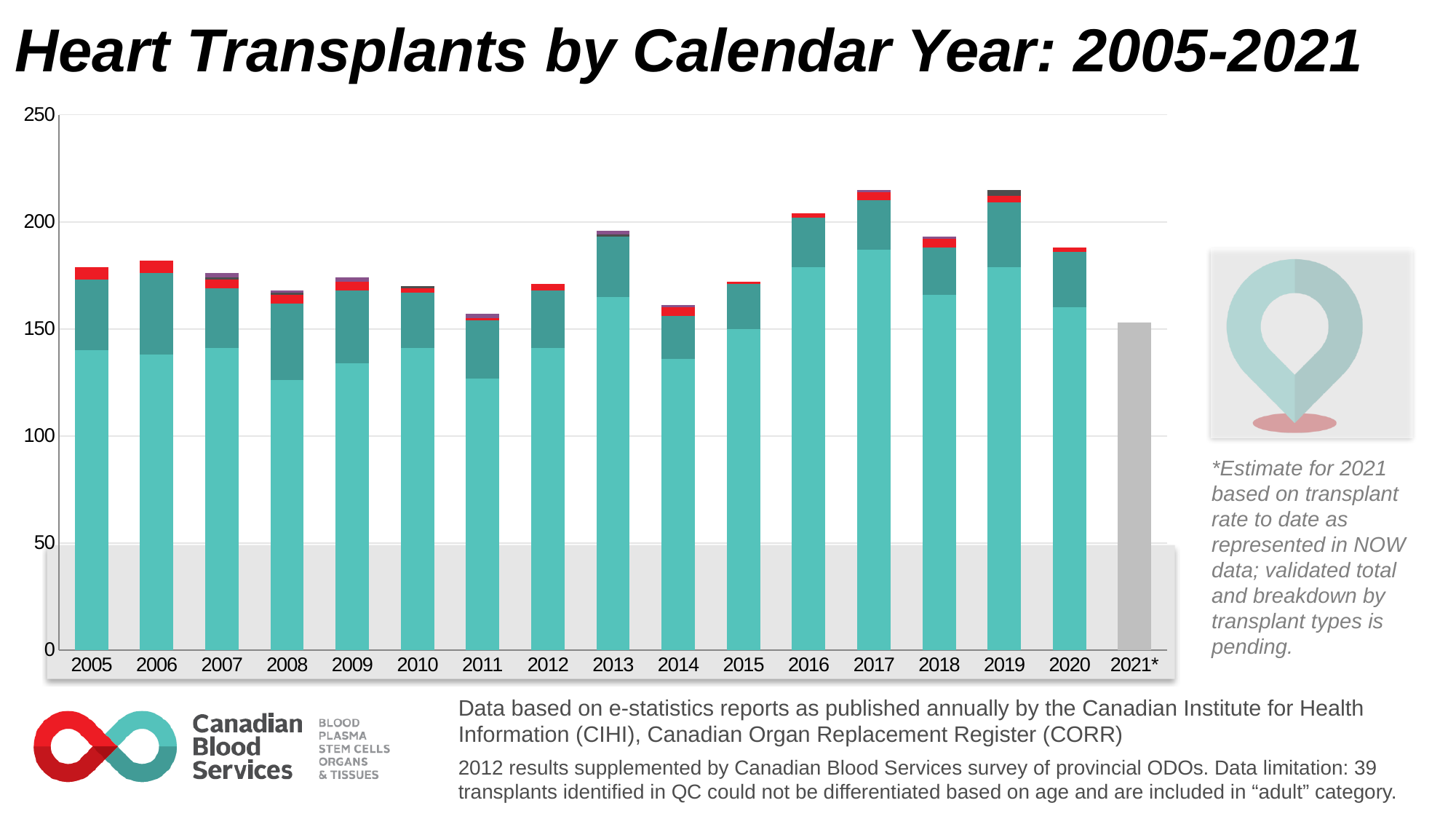
Is the total value for 2017 greater or less than 200? greater Which year has the larger total bar, 2011 or 2016? 2016 What is the title of the chart? Heart Transplants by Calendar Year: 2005-2021 Which year has the larger total bar, 2017 or 2008? 2017 Is the total value for 2020 greater or less than 200? less Is the total value for 2008 greater or less than 200? less Which year's bar is shown in grey because its value is an estimate? 2021* Do the total values rise or fall from 2014 to 2017? rise What kind of chart is shown on the slide? bar chart How many calendar years are shown on the x axis of the chart? 17